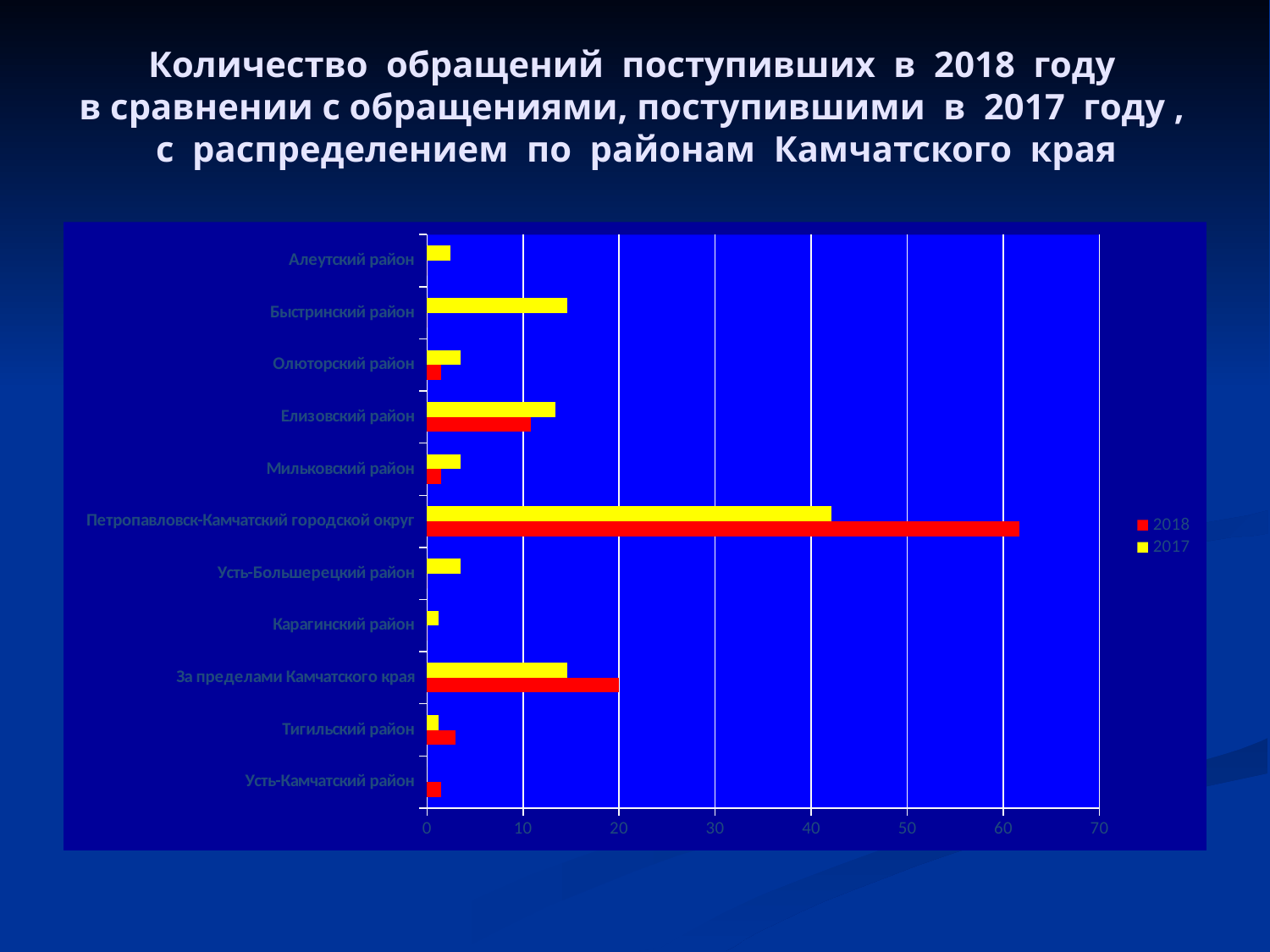
Is the 2017 value for Быстринский район greater or less than 10? greater How many series does the legend list? 2 Is the 2017 value for Алеутский район greater or less than 10? less What kind of chart is shown on the slide? bar chart Which colour represents the 2018 series in the legend? red Is the 2017 value for Петропавловск-Камчатский городской округ greater or less than 40? greater How many districts (categories) are shown on the chart? 11 Which district has the highest value for 2017? Петропавловск-Камчатский городской округ For За пределами Камчатского края, which year has the larger value, 2018 or 2017? 2018 Which district has the highest value for 2018? Петропавловск-Камчатский городской округ For Петропавловск-Камчатский городской округ, which year has the larger value, 2018 or 2017? 2018